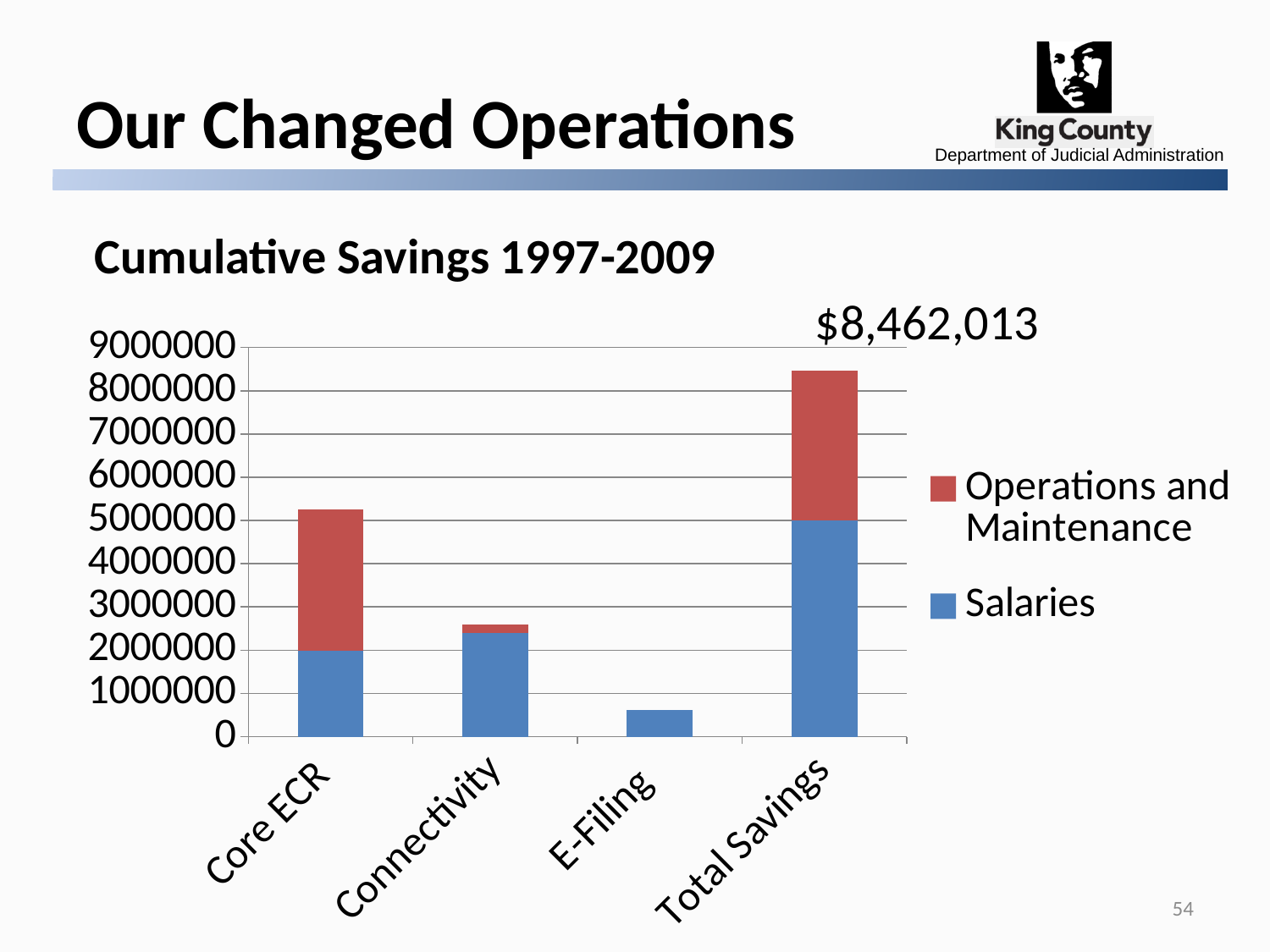
Is the value for E-Filing greater or less than 1000000? less Which category has the highest total bar in the chart? Total Savings Within the Core ECR bar, which is larger: Operations and Maintenance or Salaries? Operations and Maintenance Is the total value for Core ECR greater or less than 4000000? greater How many series does the chart's legend list? 2 How many categories are shown on the x axis of the chart? 4 Is the total value for Connectivity greater or less than 3000000? less What kind of chart is shown on the slide? bar chart What value is printed above the Total Savings bar? $8,462,013 Which category has the lowest total bar in the chart? E-Filing What is the title of the chart? Cumulative Savings 1997-2009